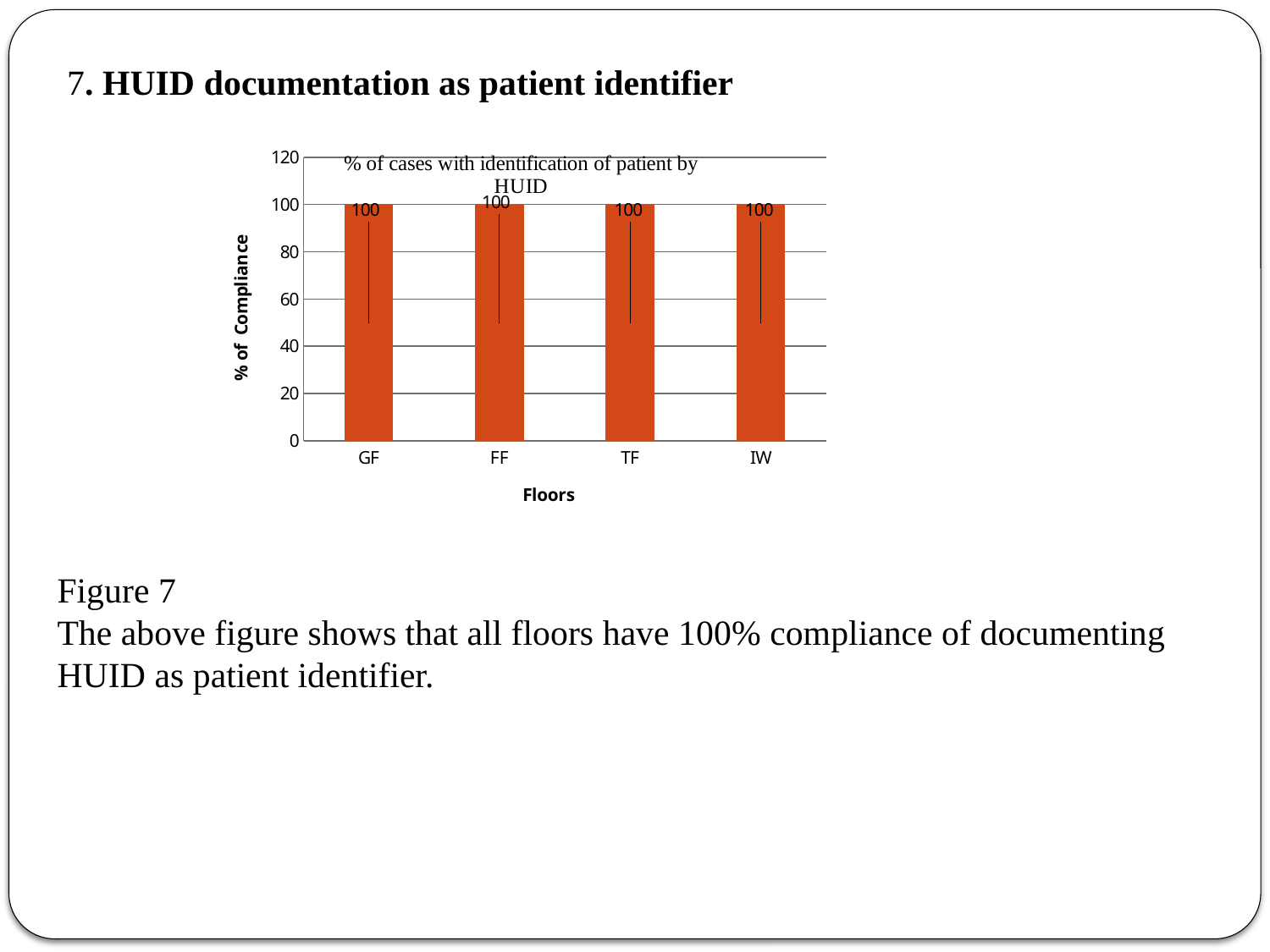
What is the value for IW? 100 Do the values rise, fall or stay the same across the floors from GF to IW? stay the same What is the value for GF? 100 What is the difference between the values for GF and IW? 0 Is the value for TF greater or less than 80? greater What is the value for TF? 100 How many floors are shown on the x axis? 4 What is the label of the x axis? Floors What is the title of the chart? % of cases with identification of patient by HUID What kind of chart is this? bar chart What is the value for FF? 100